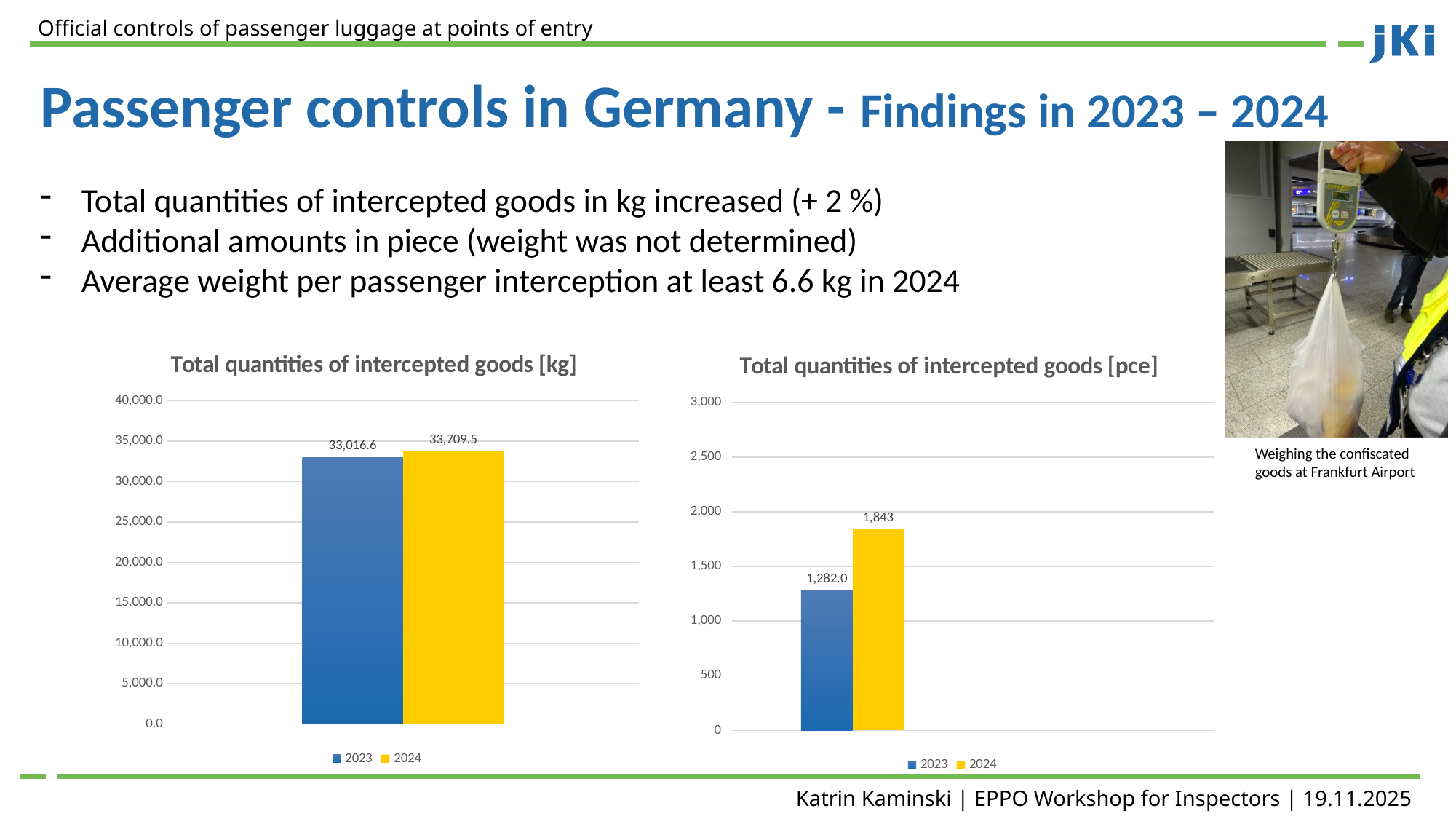
In the chart 'Total quantities of intercepted goods [pce]', is the value for 2023 greater or less than 1,500? less What kind of chart is 'Total quantities of intercepted goods [pce]'? bar chart In the chart 'Total quantities of intercepted goods [pce]', what is the value for 2023? 1,282.0 In the chart 'Total quantities of intercepted goods [kg]', which year has the lower value? 2023 In the chart 'Total quantities of intercepted goods [kg]', which colour represents 2024? yellow In the chart 'Total quantities of intercepted goods [pce]', what is the value for 2024? 1,843 In the chart 'Total quantities of intercepted goods [kg]', what is the value for 2024? 33,709.5 In the chart 'Total quantities of intercepted goods [pce]', what is the difference between the 2024 and 2023 values? 561 In the chart 'Total quantities of intercepted goods [kg]', how many series does the legend list? 2 In the chart 'Total quantities of intercepted goods [kg]', what is the value for 2023? 33,016.6 In the chart 'Total quantities of intercepted goods [pce]', which year has the higher value? 2024 In the chart 'Total quantities of intercepted goods [kg]', what is the difference between the 2024 and 2023 values? 692.9